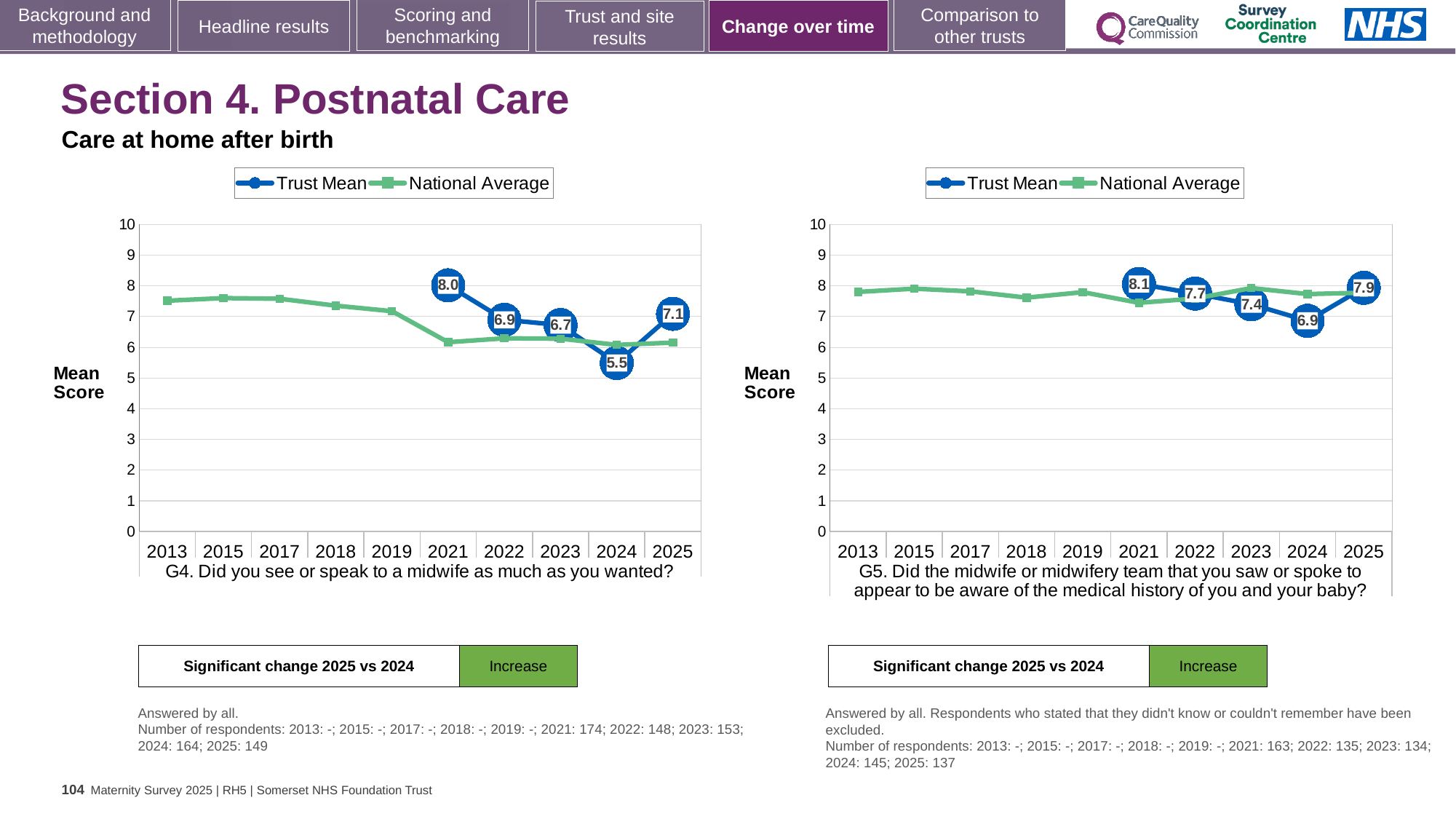
In the G4 chart (left), what is the Trust Mean for 2024? 5.5 In the G5 chart (right), which year has the lowest Trust Mean? 2024 In the G5 chart (right), what is the Trust Mean for 2025? 7.9 In the G4 chart (left), which year has the highest Trust Mean? 2021 In the G5 chart (right), what is the difference between the Trust Mean for 2021 and 2023? 0.7 In the G5 chart (right), is the Trust Mean higher in 2022 or 2024? 2022 How many years are shown on the x axis of the G4 chart (left)? 10 In the G4 chart (left), what is the Trust Mean for 2021? 8.0 In the G4 chart (left), what is the difference between the Trust Mean for 2025 and 2024? 1.6 In the G4 chart (left), is the National Average for 2013 greater or less than 7? greater How many series does the legend of the G5 chart (right) list? 2 What kind of chart is the G4 chart (left)? Line chart